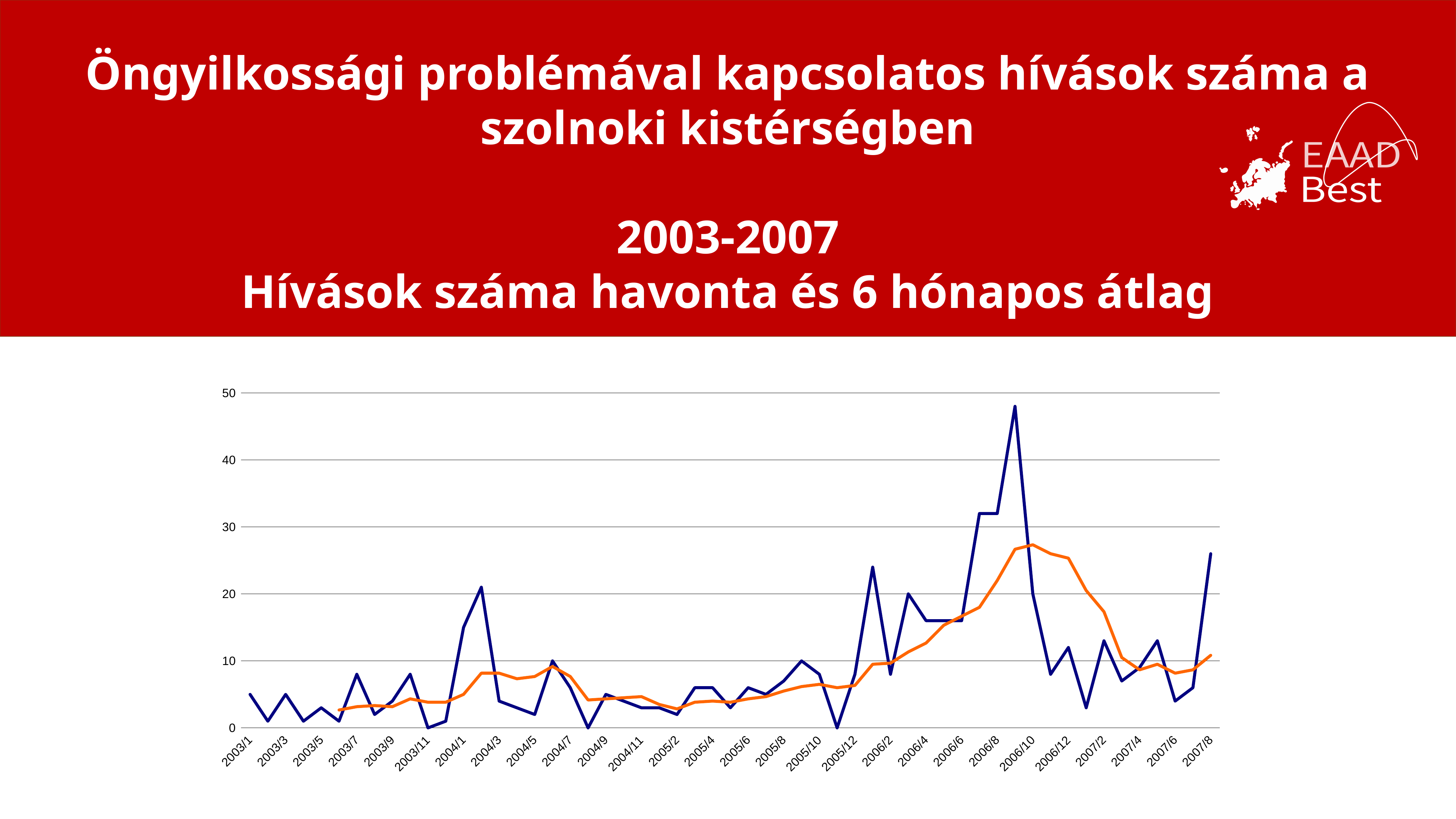
Is the value of the dark blue line at 2005/12 greater or less than 10? less What kind of chart is shown on the slide? line chart How many lines are plotted on the chart? 2 Is the value of the dark blue line at 2007/8 greater or less than 20? greater Does the orange line rise or fall between 2005/12 and 2006/10? rise At 2006/8, which line is higher, the dark blue line or the orange line? the dark blue line Is the value of the dark blue line at 2006/8 greater or less than 30? greater What is the highest value shown on the y axis? 50 What is the first month label on the x axis? 2003/1 At 2006/12, which line is higher, the dark blue line or the orange line? the orange line